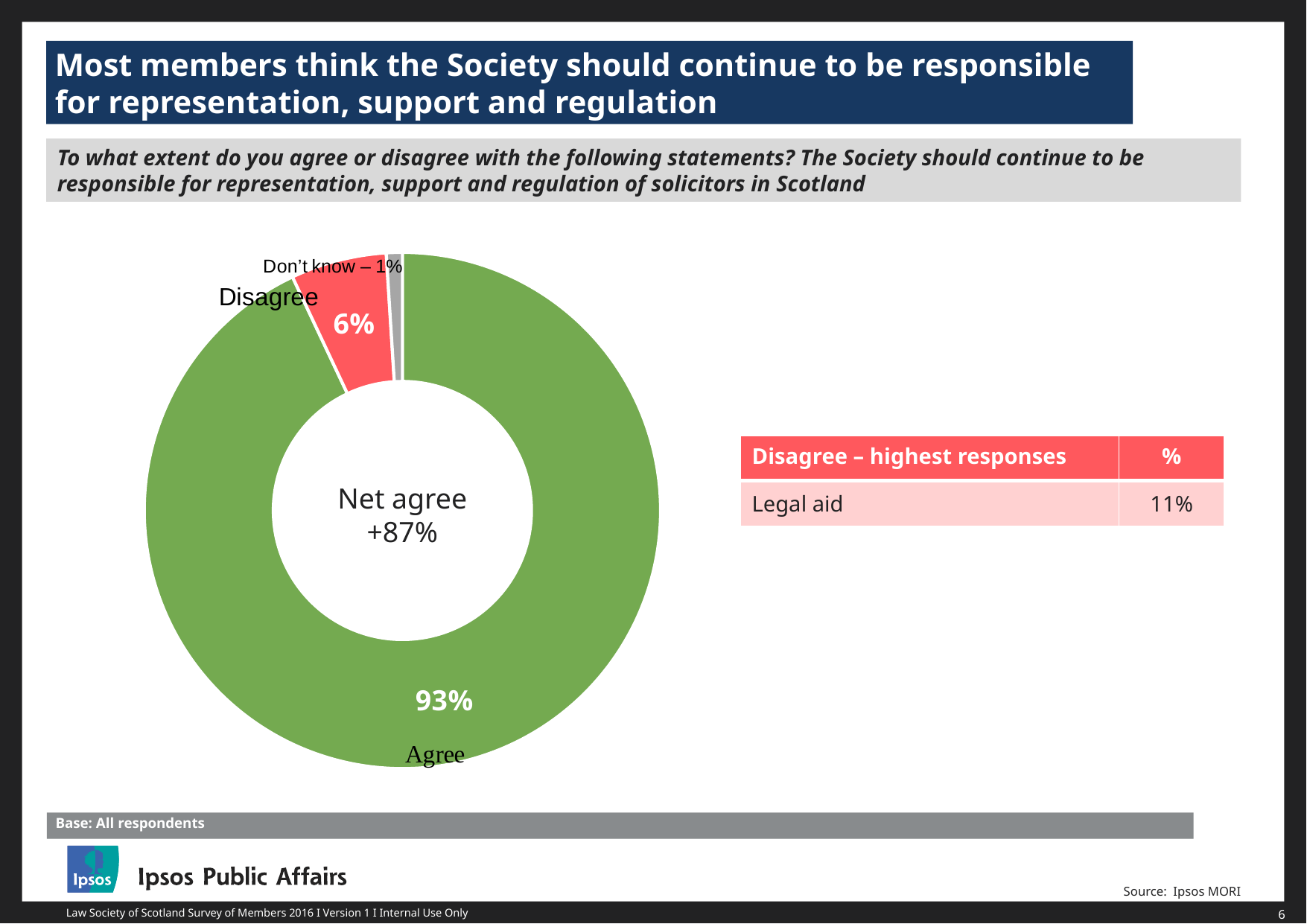
What percentage of respondents disagree? 6% What percentage of respondents answered 'Don't know'? 1% What is the difference in percentage points between Agree and Disagree? 87 Which is larger, the share for Disagree or the share for Don't know? Disagree What kind of chart is shown on the slide? Pie chart (doughnut) Which response category has the largest share of the chart? Agree What is the base for the chart, as stated on the slide? All respondents How many response categories are shown in the chart? 3 What net agree figure is shown in the centre of the chart? +87% What colour is the Agree segment of the chart? Green Which response category has the smallest share of the chart? Don't know What percentage of respondents agree that the Society should continue to be responsible for representation, support and regulation? 93%